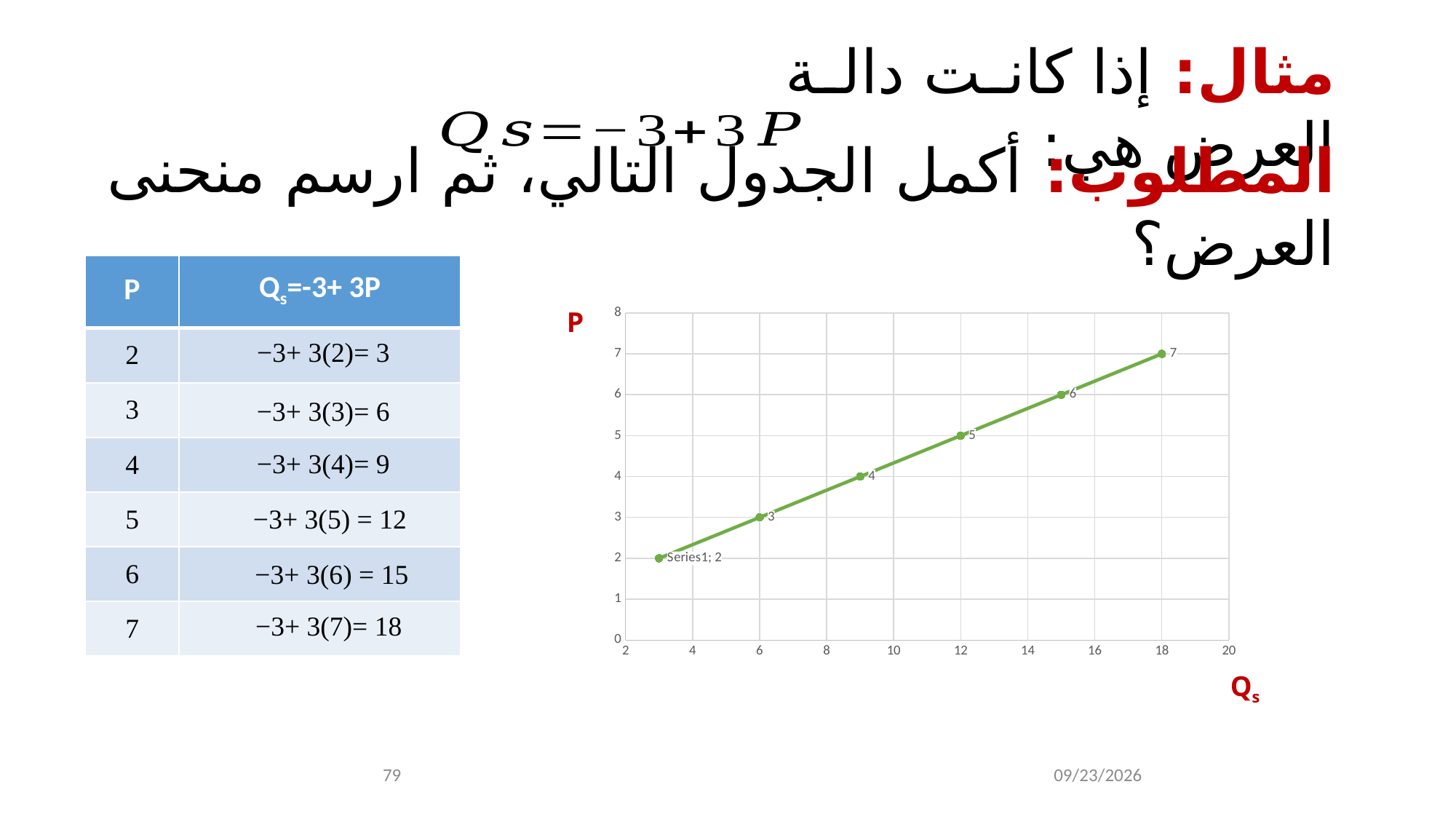
What kind of chart is shown on the slide? line chart What is the P value of the point plotted at Qs = 18? 7 How many data points are plotted on the chart? 6 Is the Qs value of the point labelled 5 greater or less than 10? greater What is the lowest P value plotted on the chart? 2 What is the highest P value plotted on the chart? 7 What is the P value of the point plotted at Qs = 6? 3 What label is shown on the vertical axis of the chart? P What is the P value of the point plotted at Qs = 12? 5 Is the Qs value of the point labelled 3 greater or less than 8? less What is the difference between the highest and lowest P values plotted on the chart? 5 Do the values of P rise or fall as Qs increases along the x axis? rise